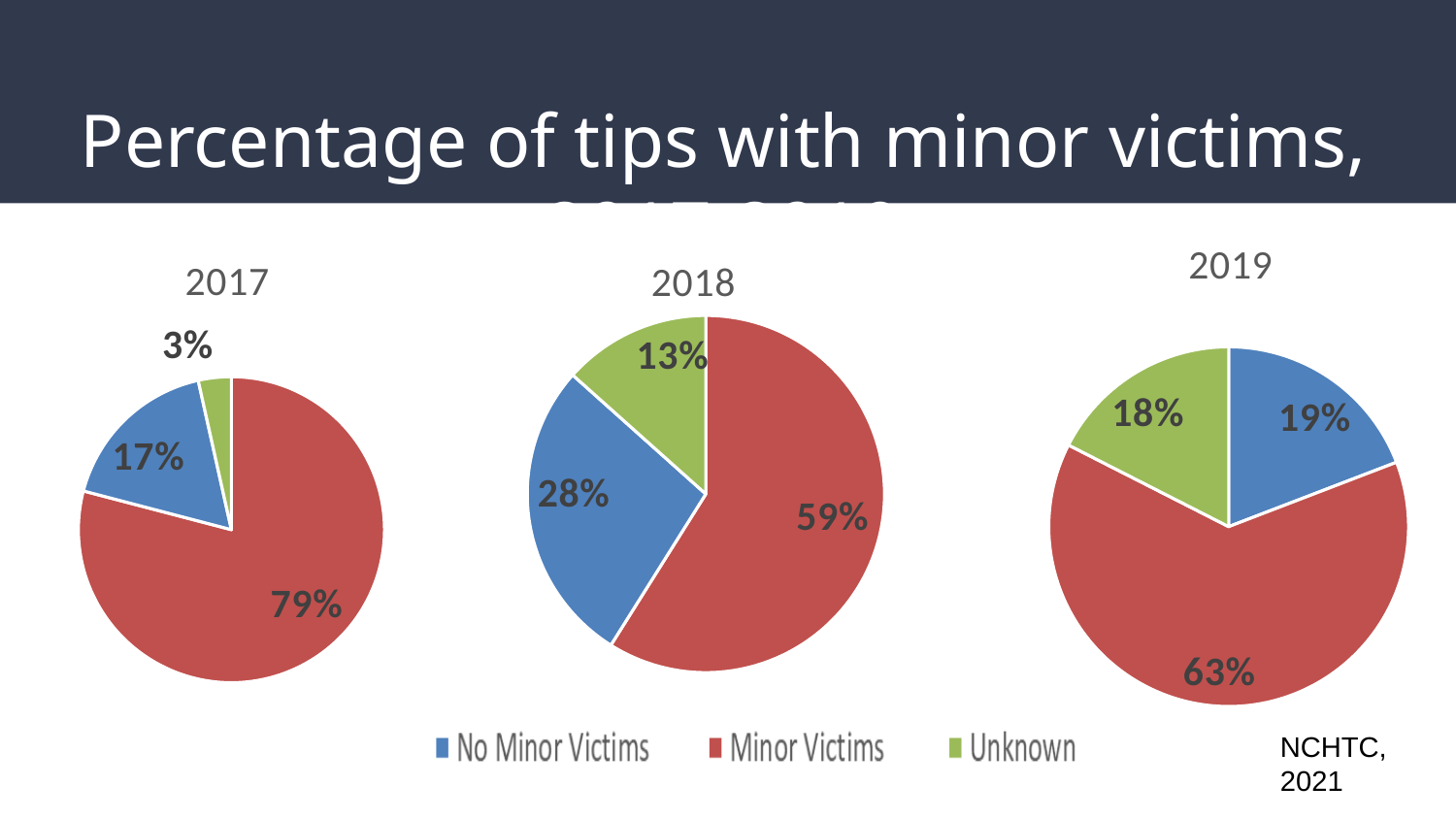
Which colour represents Minor Victims in the pie charts? Red In the 2017 pie chart, what is the difference between the Minor Victims share and the No Minor Victims share? 62% Which is larger in the 2018 pie chart: the No Minor Victims share or the Unknown share? No Minor Victims In the 2019 pie chart, which category has the smallest share? Unknown In the 2018 pie chart, what is the share for No Minor Victims? 28% In the 2019 pie chart, what is the share for Unknown? 18% In the 2017 pie chart, what percentage of tips had minor victims? 79% In the 2017 pie chart, what is the share for Unknown? 3% How many pie charts are shown on the slide? 3 How many categories does the legend list? 3 In the 2018 pie chart, which category has the largest share? Minor Victims What type of chart is used for each year on this slide? Pie chart